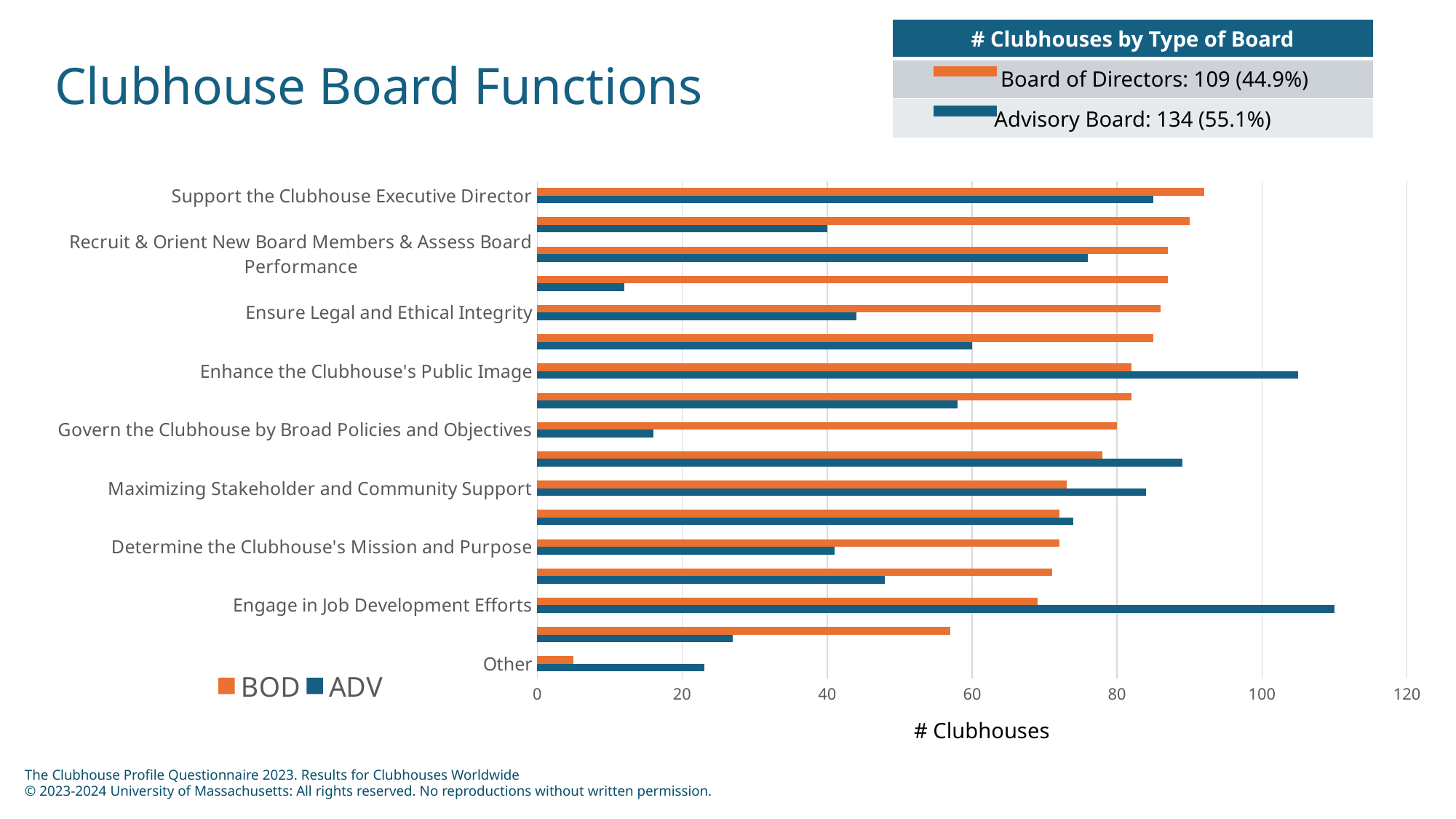
Is the BOD value for Support the Clubhouse Executive Director greater or less than 80? greater What is the title of the horizontal axis of the chart? # Clubhouses Is the BOD value for Other greater or less than 20? less Is the ADV value for Engage in Job Development Efforts greater or less than 100? greater What are the two series named in the chart legend? BOD and ADV For Engage in Job Development Efforts, which series has the larger value, BOD or ADV? ADV What kind of chart is shown on the slide? bar chart How many series does the chart legend list? 2 Which labeled board function has the lowest BOD value? Other For Govern the Clubhouse by Broad Policies and Objectives, which series has the larger value, BOD or ADV? BOD